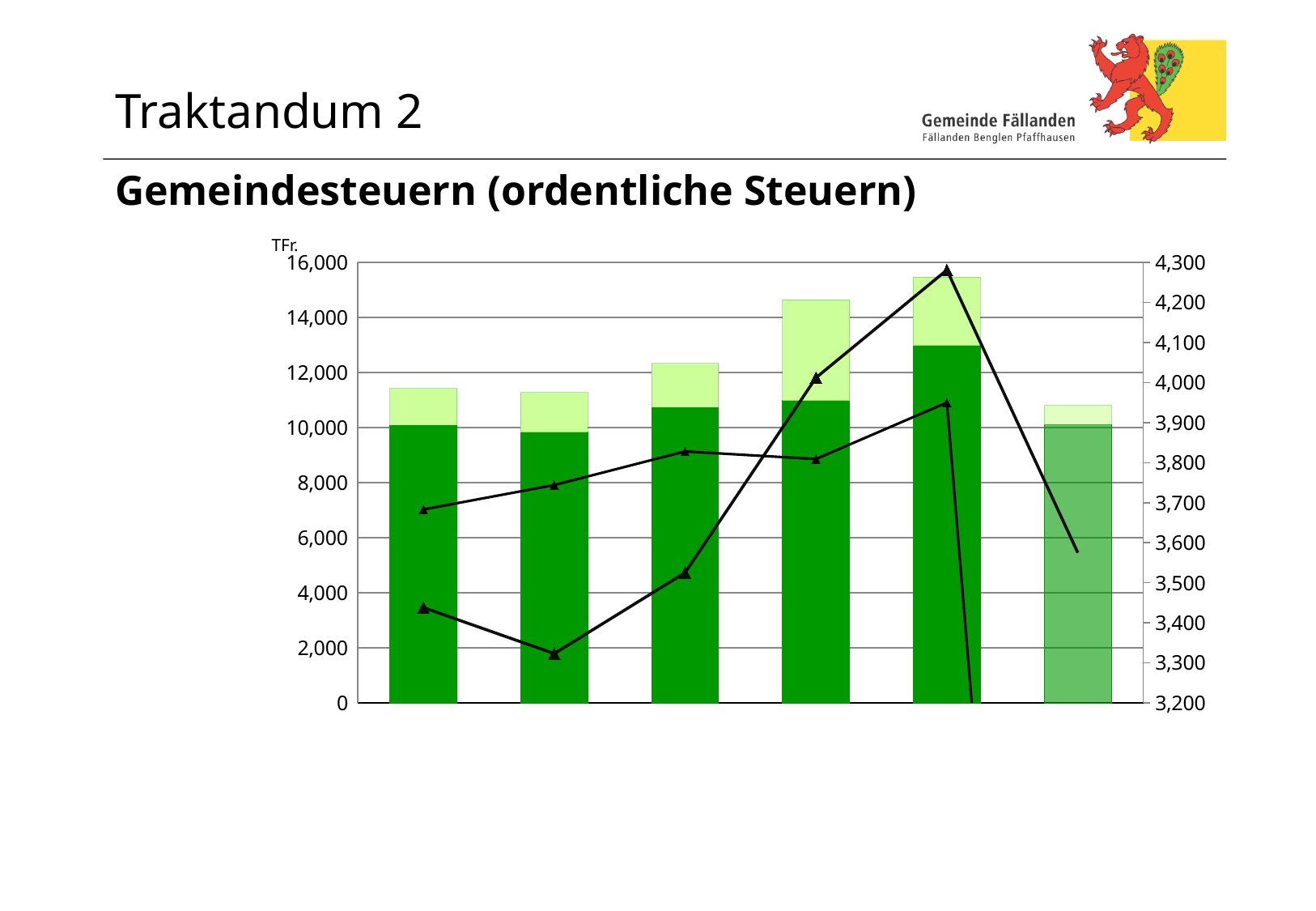
How many line series are drawn on the chart? 2 Which bar (by position from left) reaches the highest total? The fifth bar Is the total of the fifth bar greater or less than 14,000? greater How many bars are plotted in the chart? 6 What unit label is shown above the left axis? TFr. What is the title of the chart? Gemeindesteuern (ordentliche Steuern) Is the total of the sixth (rightmost) bar greater or less than 12,000? less Which is taller, the fifth bar or the first bar? The fifth bar Is the total of the first bar greater or less than 10,000? greater What kind of chart is shown on the slide? A bar chart combined with line series Do the dark green bar segments rise or fall from the first bar to the fifth bar? rise